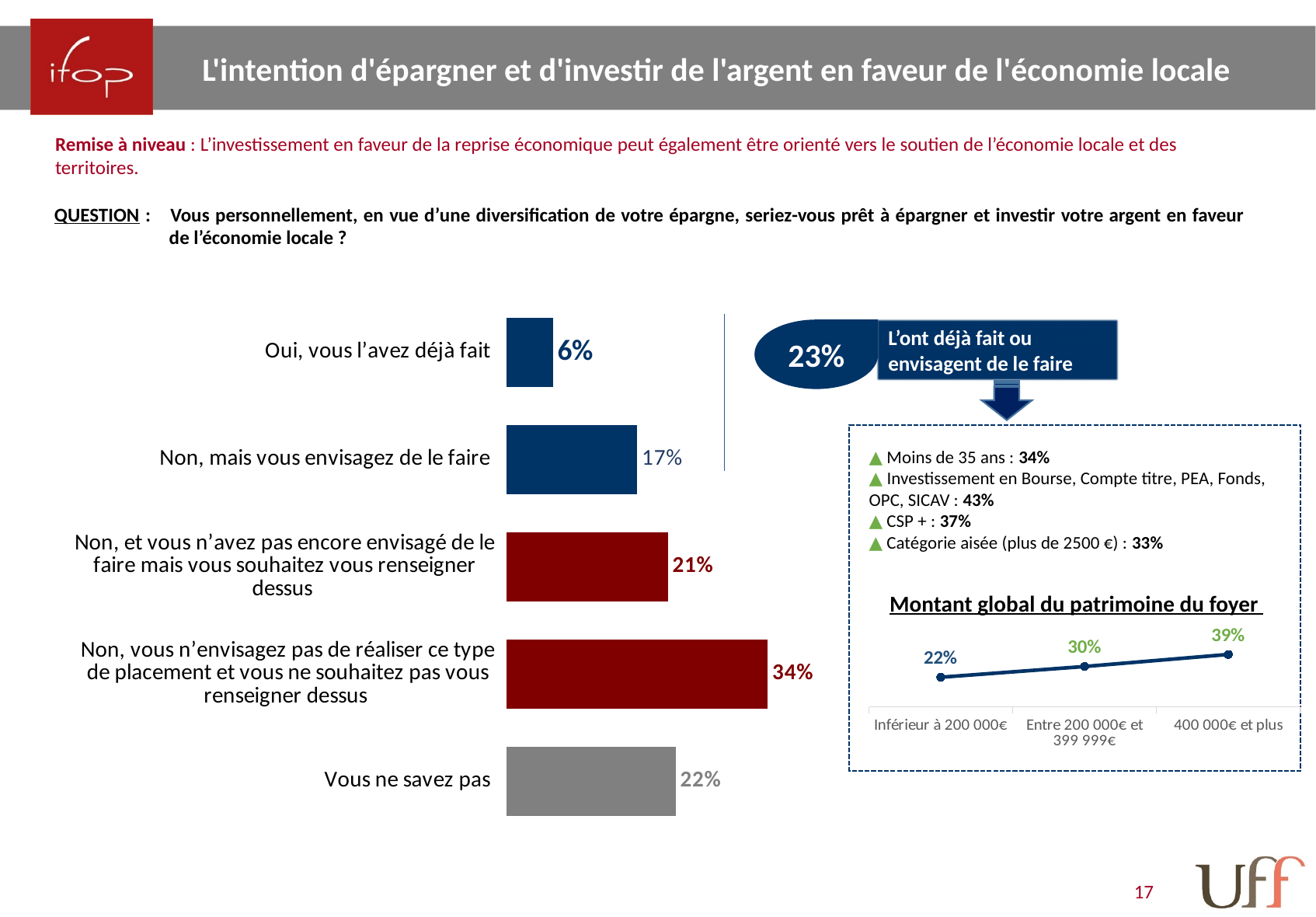
In the bar chart on the left, what is the value for "Oui, vous l'avez déjà fait"? 6% What kind of chart is the chart on the left of the slide? Bar chart In the bar chart on the left, which category has the highest value? Non, vous n'envisagez pas de réaliser ce type de placement et vous ne souhaitez pas vous renseigner dessus In the bar chart on the left, which is larger: the value for "Vous ne savez pas" or the value for "Non, mais vous envisagez de le faire"? Vous ne savez pas In the bar chart on the left, what is the difference between the value for "Non, vous n'envisagez pas de réaliser ce type de placement..." and the value for "Non, et vous n'avez pas encore envisagé de le faire..."? 13% In the chart titled "Montant global du patrimoine du foyer", do the values rise or fall from left to right? Rise In the chart titled "Montant global du patrimoine du foyer", what is the difference between the value for "400 000€ et plus" and the value for "Inférieur à 200 000€"? 17% In the bar chart on the left, what is the value for "Vous ne savez pas"? 22% How many categories does the bar chart on the left show? 5 In the bar chart on the left, which category has the lowest value? Oui, vous l'avez déjà fait In the chart titled "Montant global du patrimoine du foyer", what is the value for "Entre 200 000€ et 399 999€"? 30% In the bar chart on the left, what is the value for "Non, mais vous envisagez de le faire"? 17%